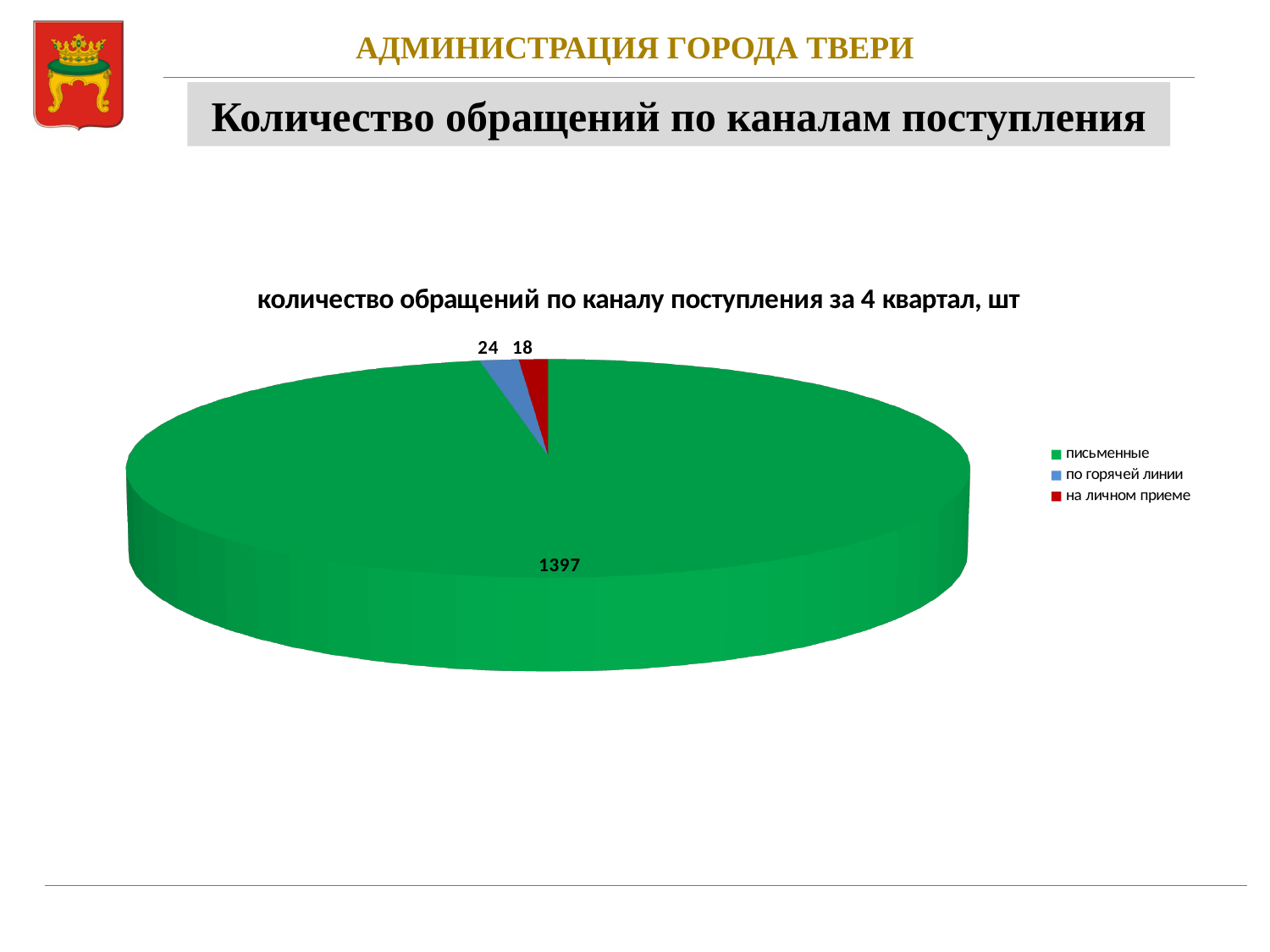
What is the difference between the values for по горячей линии and на личном приеме? 6 What is the value for письменные in the pie chart? 1397 Which is larger: the value for по горячей линии or the value for на личном приеме? по горячей линии What is the title of the pie chart? количество обращений по каналу поступления за 4 квартал, шт What is the value for по горячей линии in the pie chart? 24 What is the value for на личном приеме in the pie chart? 18 Which channel has the smallest number of appeals in the pie chart? на личном приеме What is the total of all three values shown in the pie chart? 1439 What type of chart is shown on the slide? Pie chart How many slices does the pie chart have? 3 Which channel has the largest number of appeals in the pie chart? письменные How many entries does the legend of the pie chart list? 3